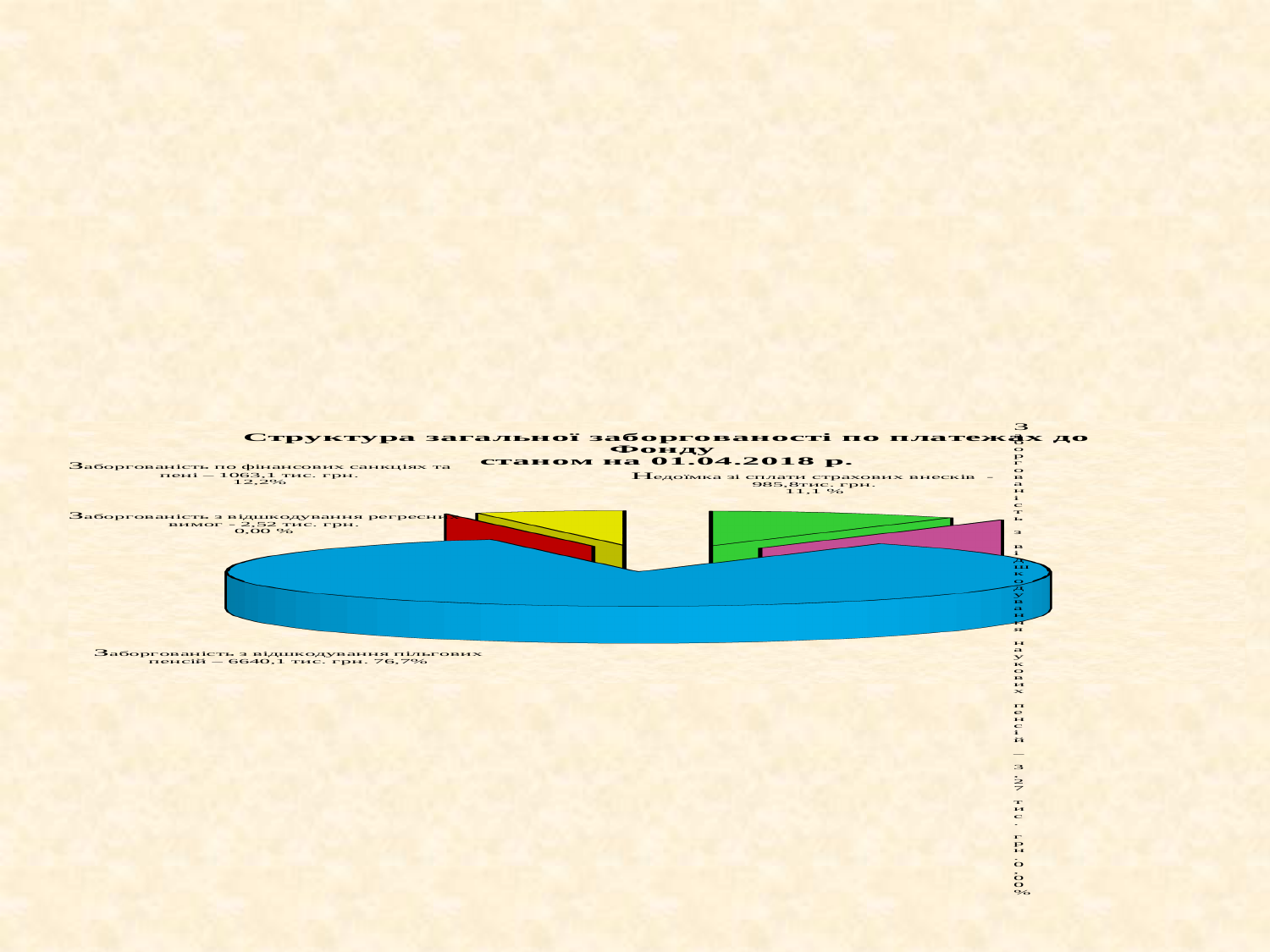
What share of the pie does "Недоїмка зі сплати страхових внесків" represent? 11,1 % What is the title of the chart? Структура загальної заборгованості по платежах до Фонду станом на 01.04.2018 р. What is the value for "Заборгованість по фінансових санкціях та пені"? 1063,1 тис. грн. What is the value for "Заборгованість з відшкодування пільгових пенсій"? 6640,1 тис. грн. Which category has the largest share of the pie? Заборгованість з відшкодування пільгових пенсій What kind of chart is shown on the slide? Pie chart What is the value for "Заборгованість з відшкодування регресних вимог"? 2,52 тис. грн. Which is larger: "Заборгованість по фінансових санкціях та пені" or "Недоїмка зі сплати страхових внесків"? Заборгованість по фінансових санкціях та пені What share of the pie does "Заборгованість по фінансових санкціях та пені" represent? 12,2% What share of the pie does "Заборгованість з відшкодування пільгових пенсій" represent? 76,7% What is the value for "Недоїмка зі сплати страхових внесків"? 985,8 тис. грн. What is the difference between "Заборгованість по фінансових санкціях та пені" and "Недоїмка зі сплати страхових внесків" in тис. грн.? 77,3 тис. грн.